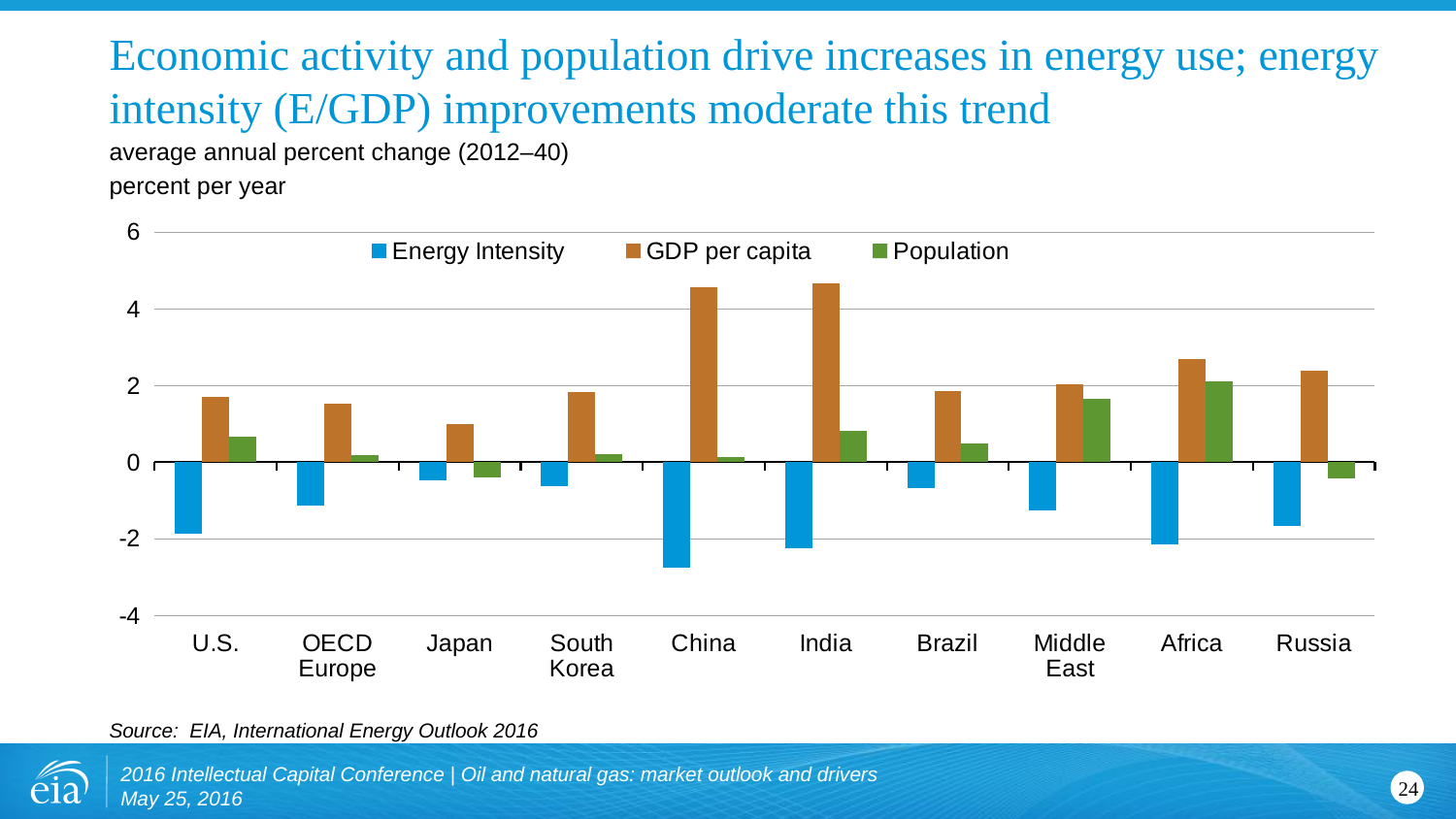
Is the Energy Intensity value for U.S. greater or less than -1? less Is the Population value for Japan greater or less than 0? less What kind of chart is shown on the slide? bar chart How many series does the legend list? 3 Is the GDP per capita value for China greater or less than 4? greater Which series is shown in blue in the legend? Energy Intensity Which country or region has the lowest GDP per capita value? Japan How many countries or regions are shown on the x axis? 10 Which country or region has the highest Population value? Africa Which country or region has the lowest (most negative) Energy Intensity value? China Which is larger, the GDP per capita value for Africa or for Brazil? Africa